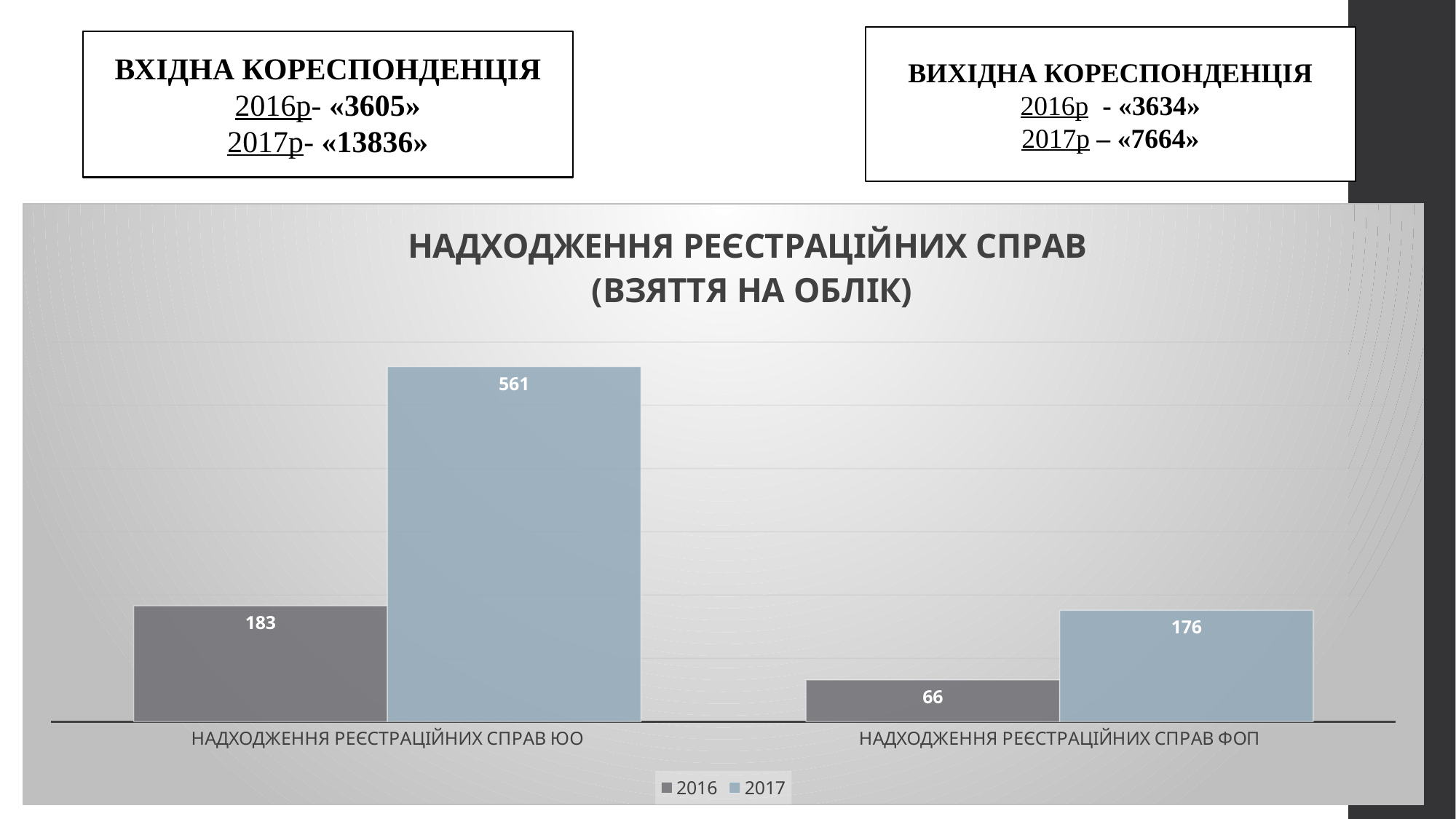
Which is larger: the 2016 value for НАДХОДЖЕННЯ РЕЄСТРАЦІЙНИХ СПРАВ ЮО or the 2017 value for НАДХОДЖЕННЯ РЕЄСТРАЦІЙНИХ СПРАВ ФОП? 2016 value for НАДХОДЖЕННЯ РЕЄСТРАЦІЙНИХ СПРАВ ЮО Which bar has the lowest value in the chart? 2016, НАДХОДЖЕННЯ РЕЄСТРАЦІЙНИХ СПРАВ ФОП What is the value for 2016 in the category НАДХОДЖЕННЯ РЕЄСТРАЦІЙНИХ СПРАВ ЮО? 183 How many categories are shown on the x axis of the chart? 2 What type of chart is shown on the slide? Bar chart What is the value for 2017 in the category НАДХОДЖЕННЯ РЕЄСТРАЦІЙНИХ СПРАВ ЮО? 561 Which bar has the highest value in the chart? 2017, НАДХОДЖЕННЯ РЕЄСТРАЦІЙНИХ СПРАВ ЮО What is the value for 2017 in the category НАДХОДЖЕННЯ РЕЄСТРАЦІЙНИХ СПРАВ ФОП? 176 How many series does the chart legend list? 2 What is the value for 2016 in the category НАДХОДЖЕННЯ РЕЄСТРАЦІЙНИХ СПРАВ ФОП? 66 What is the difference between the 2017 and 2016 values for НАДХОДЖЕННЯ РЕЄСТРАЦІЙНИХ СПРАВ ЮО? 378 What is the difference between the 2017 and 2016 values for НАДХОДЖЕННЯ РЕЄСТРАЦІЙНИХ СПРАВ ФОП? 110